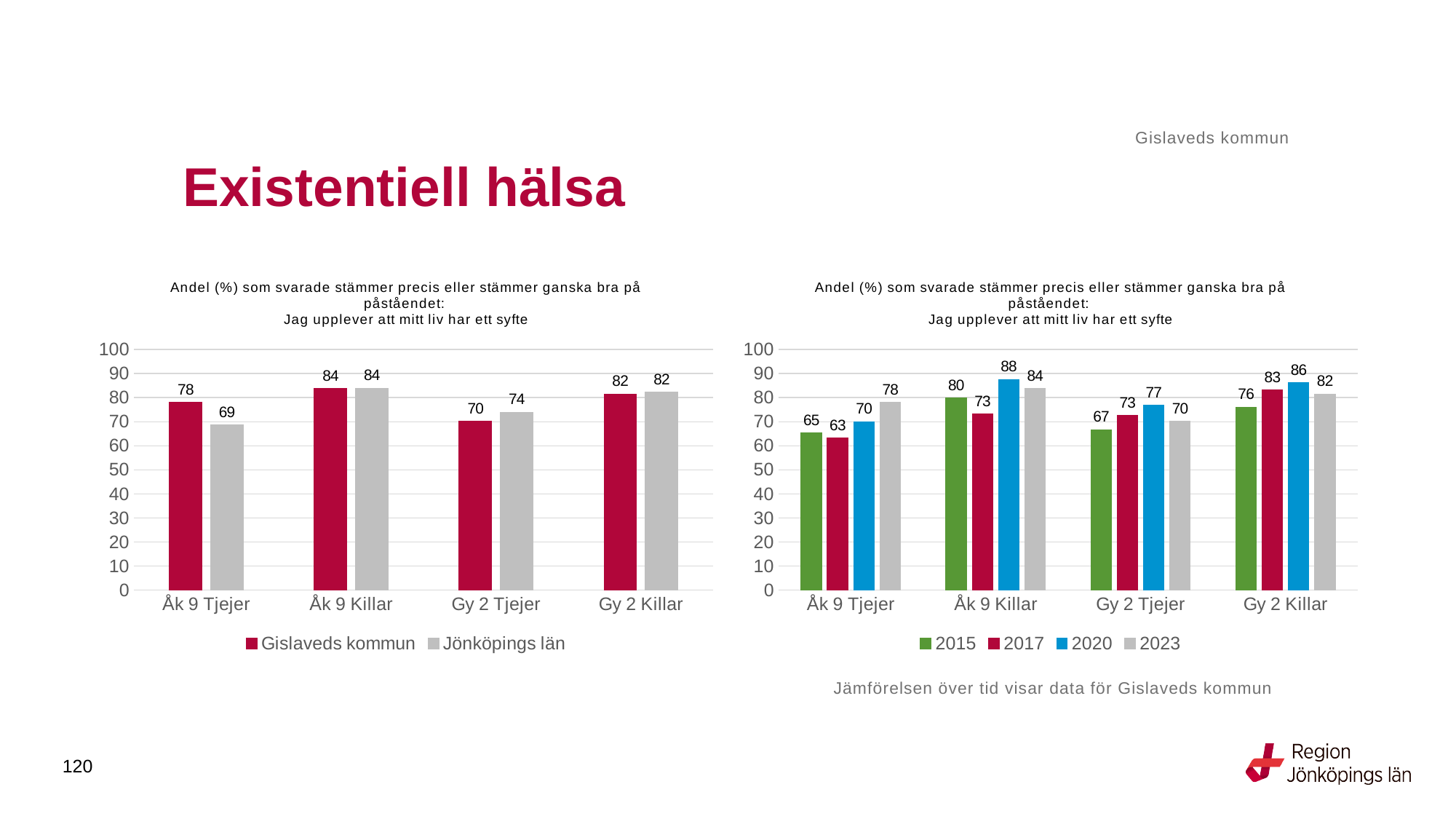
What kind of chart is the left chart? Bar chart In the right chart, is the 2017 value for Åk 9 Tjejer larger or smaller than the 2023 value for Åk 9 Tjejer? smaller In the right chart, what is the difference between the 2023 and 2015 values for Åk 9 Tjejer? 13 In the left chart, what is the value for Jönköpings län for Gy 2 Tjejer? 74 In the right chart, how many series does the legend list? 4 In the right chart, which year has the highest value for Gy 2 Killar? 2020 In the right chart, what is the value for 2015 for Gy 2 Tjejer? 67 In the left chart, what is the difference between Gislaveds kommun and Jönköpings län for Åk 9 Tjejer? 9 In the right chart, what is the value for 2020 for Åk 9 Killar? 88 In the left chart, which category has the lowest value for Jönköpings län? Åk 9 Tjejer In the left chart, what is the value for Gislaveds kommun for Åk 9 Tjejer? 78 In the left chart, how many series does the legend list? 2